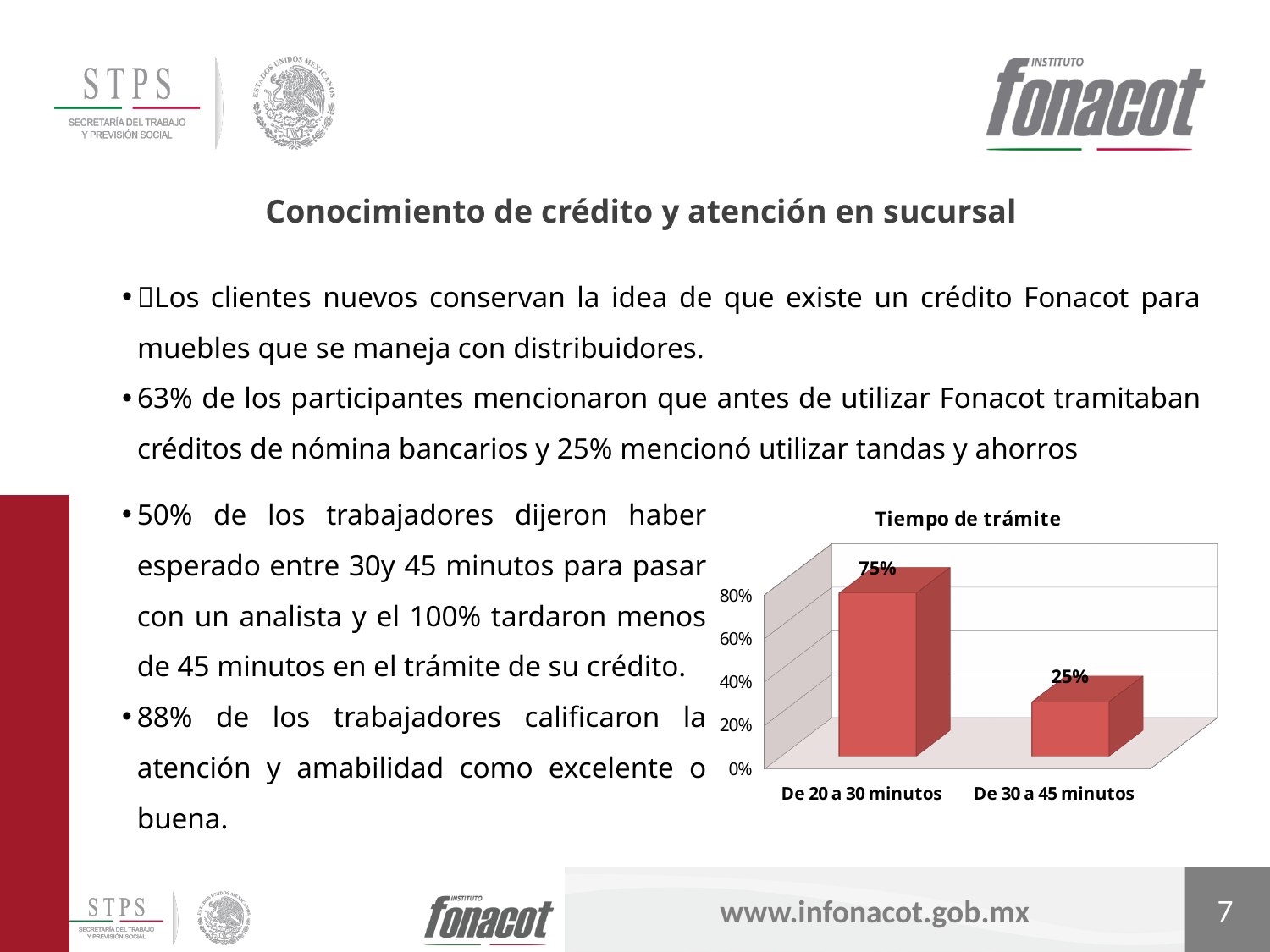
What kind of chart is 'Tiempo de trámite'? bar chart What is the title of the chart on the slide? Tiempo de trámite What is the value for 'De 20 a 30 minutos' in the 'Tiempo de trámite' chart? 75% How many categories are shown in the 'Tiempo de trámite' chart? 2 In the 'Tiempo de trámite' chart, which is larger: 'De 20 a 30 minutos' or 'De 30 a 45 minutos'? De 20 a 30 minutos What is the value for 'De 30 a 45 minutos' in the 'Tiempo de trámite' chart? 25% Is the value for 'De 30 a 45 minutos' greater or less than 40%? less Which category has the lowest value in the 'Tiempo de trámite' chart? De 30 a 45 minutos Which category has the highest value in the 'Tiempo de trámite' chart? De 20 a 30 minutos What is the difference between the values for 'De 20 a 30 minutos' and 'De 30 a 45 minutos' in the 'Tiempo de trámite' chart? 50% Is the value for 'De 20 a 30 minutos' greater or less than 60%? greater Do the values rise or fall from left to right in the 'Tiempo de trámite' chart? fall